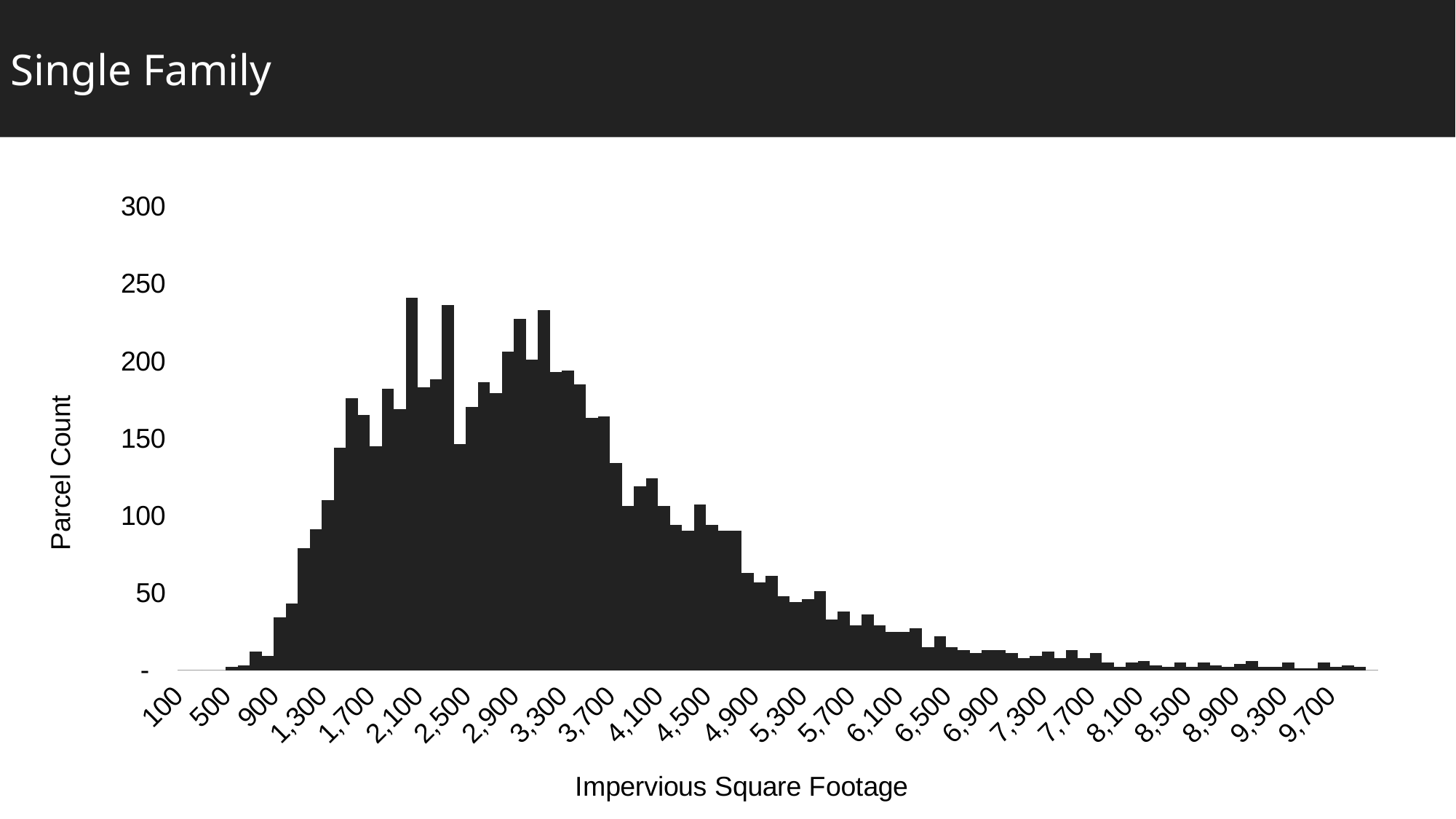
Is the parcel count at 4,900 square feet greater or less than 100? less What is the title of the horizontal axis? Impervious Square Footage Is the parcel count at 2,100 square feet greater or less than 200? less Which has the larger parcel count, 2,100 square feet or 5,300 square feet? 2,100 How many labels are shown on the horizontal axis? 25 Is the parcel count at 5,700 square feet greater or less than 50? less What is the title of the vertical axis? Parcel Count What kind of chart is shown on the slide? bar chart Do the parcel counts generally rise or fall as impervious square footage increases from 3,300 to 9,700? fall